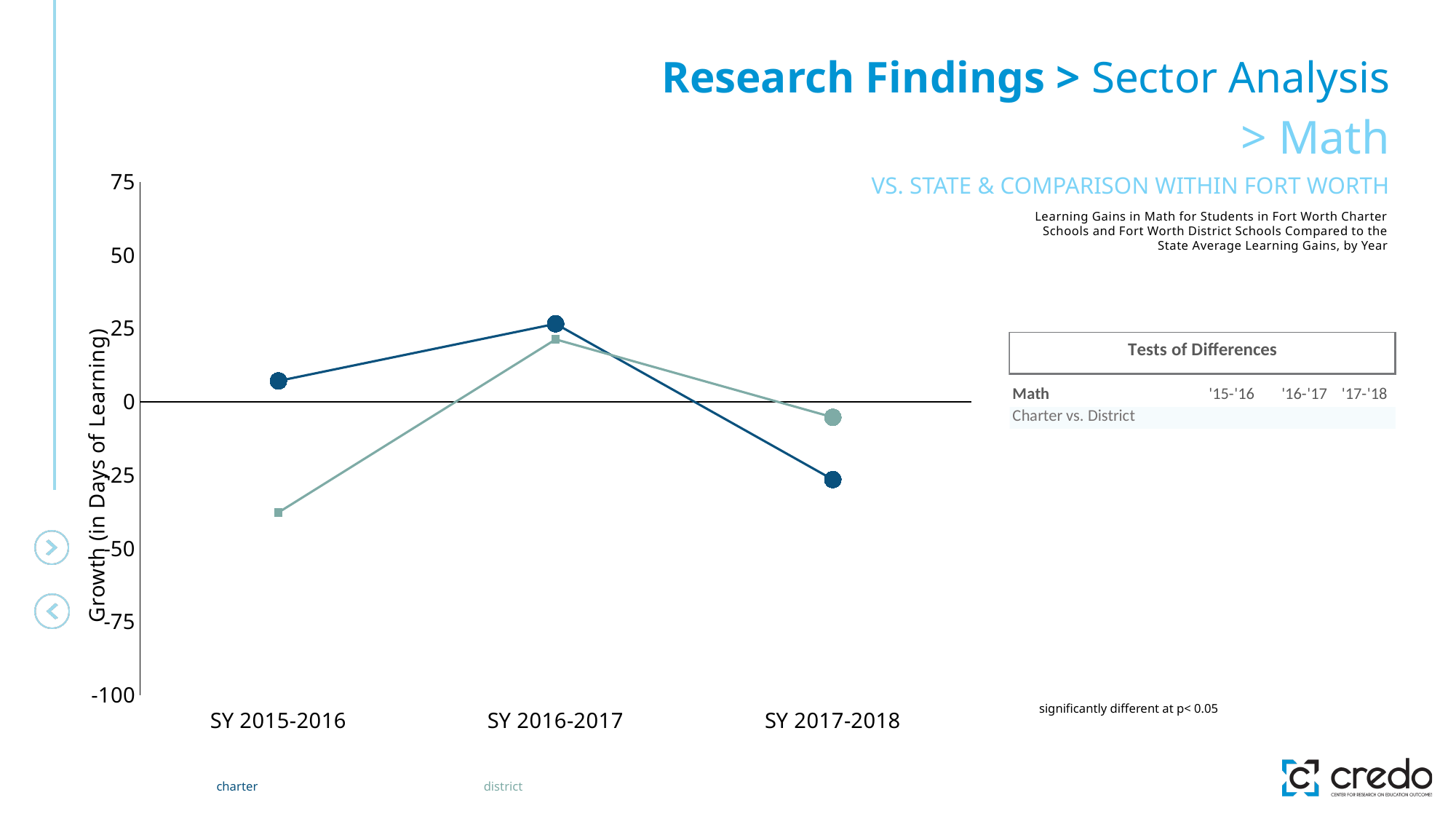
In SY 2015-2016, which series has the larger value, charter or district? charter How many series does the chart's legend list? 2 Is the value for charter in SY 2017-2018 greater or less than 0? less In which school year is the district series at its highest value? SY 2016-2017 How many school years are plotted on the x axis of the chart? 3 What is the label on the chart's vertical axis? Growth (in Days of Learning) In which school year is the charter series at its highest value? SY 2016-2017 Is the value for district in SY 2015-2016 greater or less than -25? less In SY 2017-2018, which series has the larger value, charter or district? district What kind of chart is shown on the slide? line chart In which school year is the charter series at its lowest value? SY 2017-2018 In which school year is the district series at its lowest value? SY 2015-2016